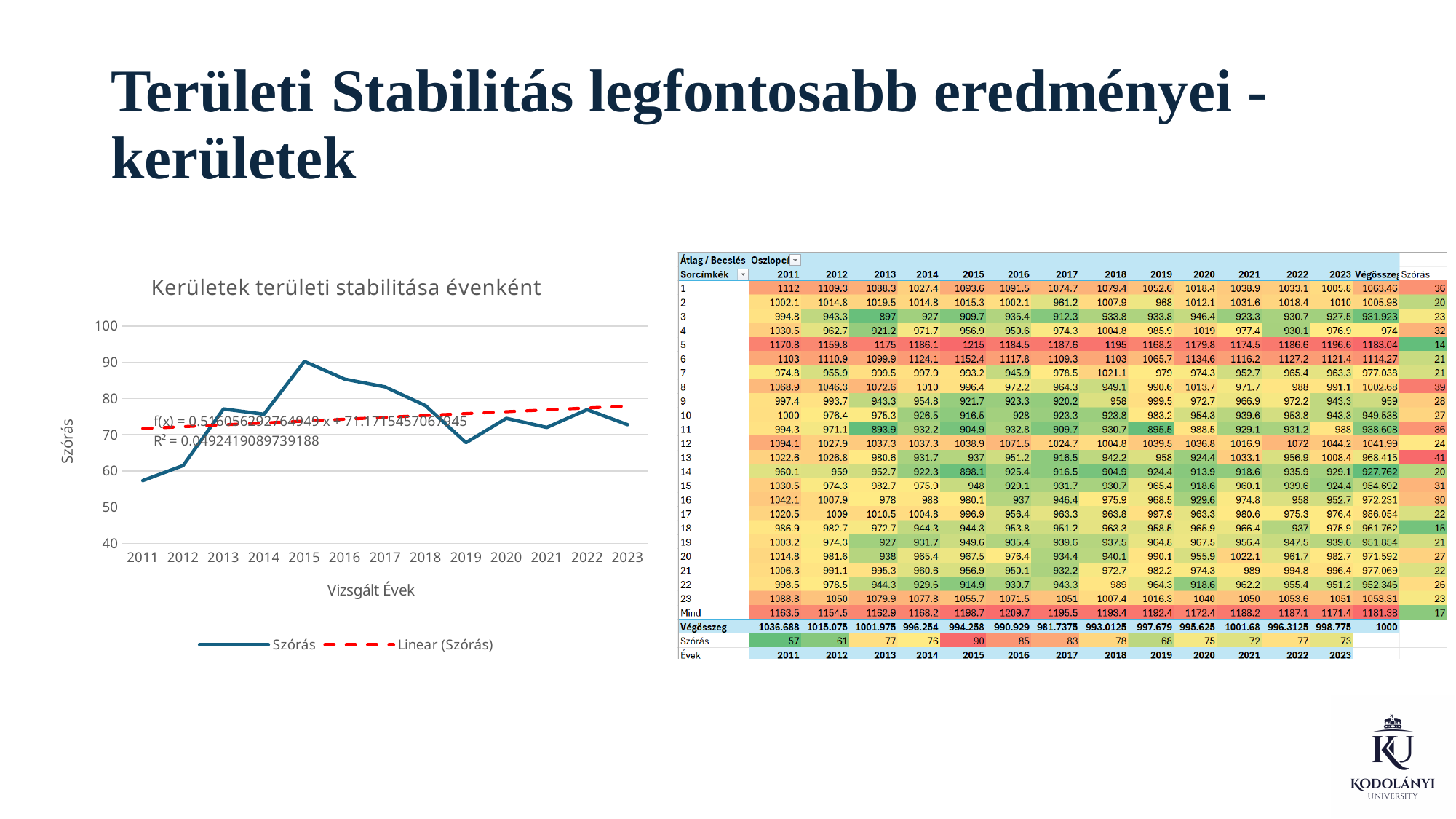
In the chart "Kerületek területi stabilitása évenként", is the Szórás value for 2011 greater or less than 60? less In the chart "Kerületek területi stabilitása évenként", which year has a higher Szórás value, 2015 or 2016? 2015 In the chart "Kerületek területi stabilitása évenként", which year has the lowest Szórás value? 2011 What kind of chart is "Kerületek területi stabilitása évenként"? line chart In the chart "Kerületek területi stabilitása évenként", what is the Szórás value for 2015? 90 In the chart "Kerületek területi stabilitása évenként", which year has a higher Szórás value, 2019 or 2020? 2020 In the chart "Kerületek területi stabilitása évenként", which year has the highest Szórás value? 2015 How many entries does the legend of the chart "Kerületek területi stabilitása évenként" list? 2 How many years are shown on the x axis of the chart "Kerületek területi stabilitása évenként"? 13 In the chart "Kerületek területi stabilitása évenként", does the Szórás value rise or fall from 2011 to 2015? rise In the chart "Kerületek területi stabilitása évenként", is the Szórás value for 2016 greater or less than 80? greater In the chart "Kerületek területi stabilitása évenként", is the Szórás value for 2019 greater or less than 70? less